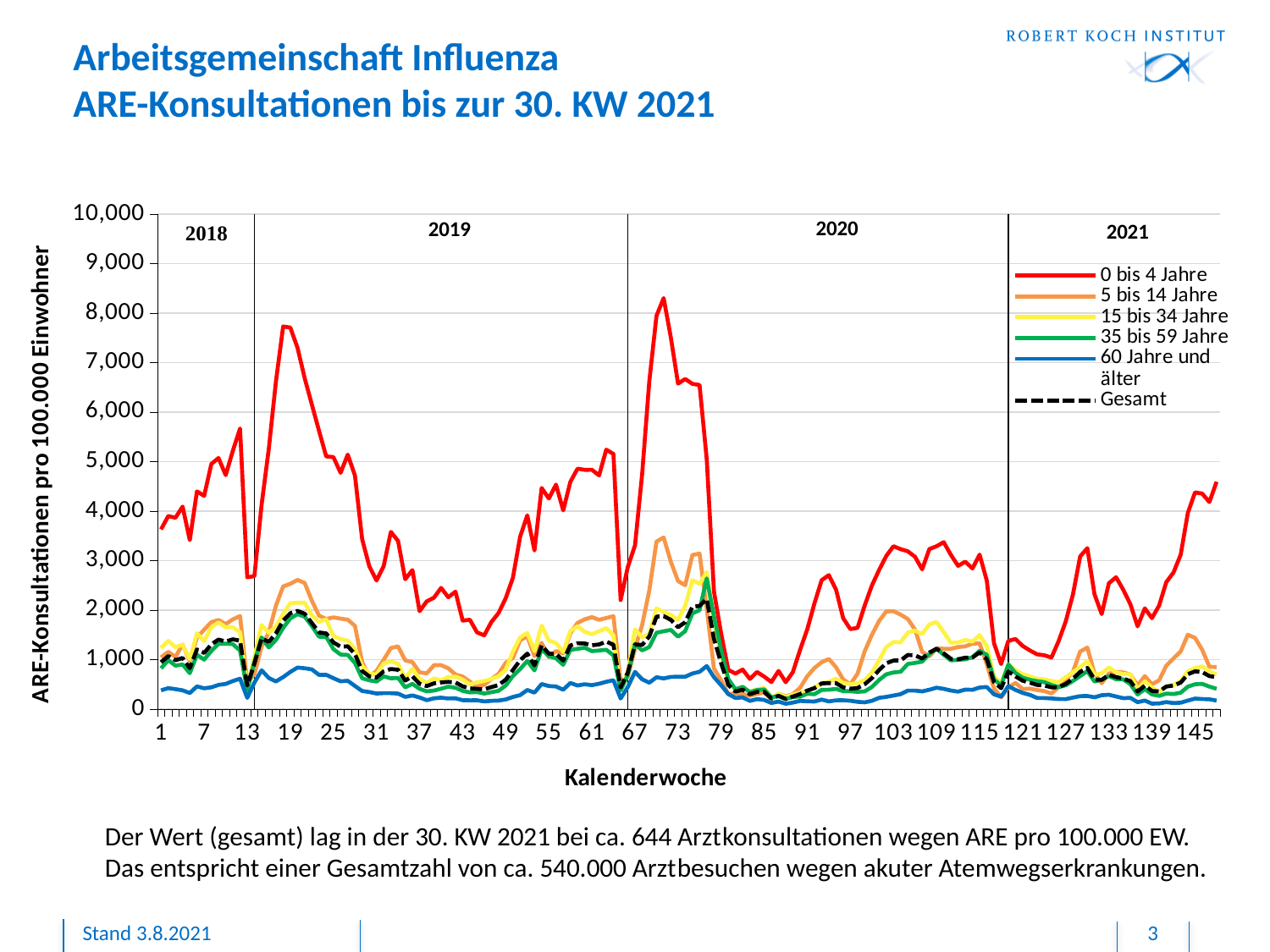
What kind of chart is shown on the slide? line chart What is the maximum value shown on the y axis? 10,000 Is the peak value of the 0 bis 4 Jahre series in 2020 greater or less than 8,000? greater How many years are marked along the top of the chart? 4 Is the peak value of the 0 bis 4 Jahre series in 2019 greater or less than 8,000? less Which age group series reaches the highest values in the chart? 0 bis 4 Jahre What is the label of the y axis? ARE-Konsultationen pro 100.000 Einwohner Around calendar week 70, which series is larger: 0 bis 4 Jahre or 60 Jahre und älter? 0 bis 4 Jahre Which age group series stays lowest throughout the chart? 60 Jahre und älter Is the 60 Jahre und älter series ever greater or less than 1,000 across the whole chart? less How many series does the legend list? 6 What is the label of the x axis? Kalenderwoche